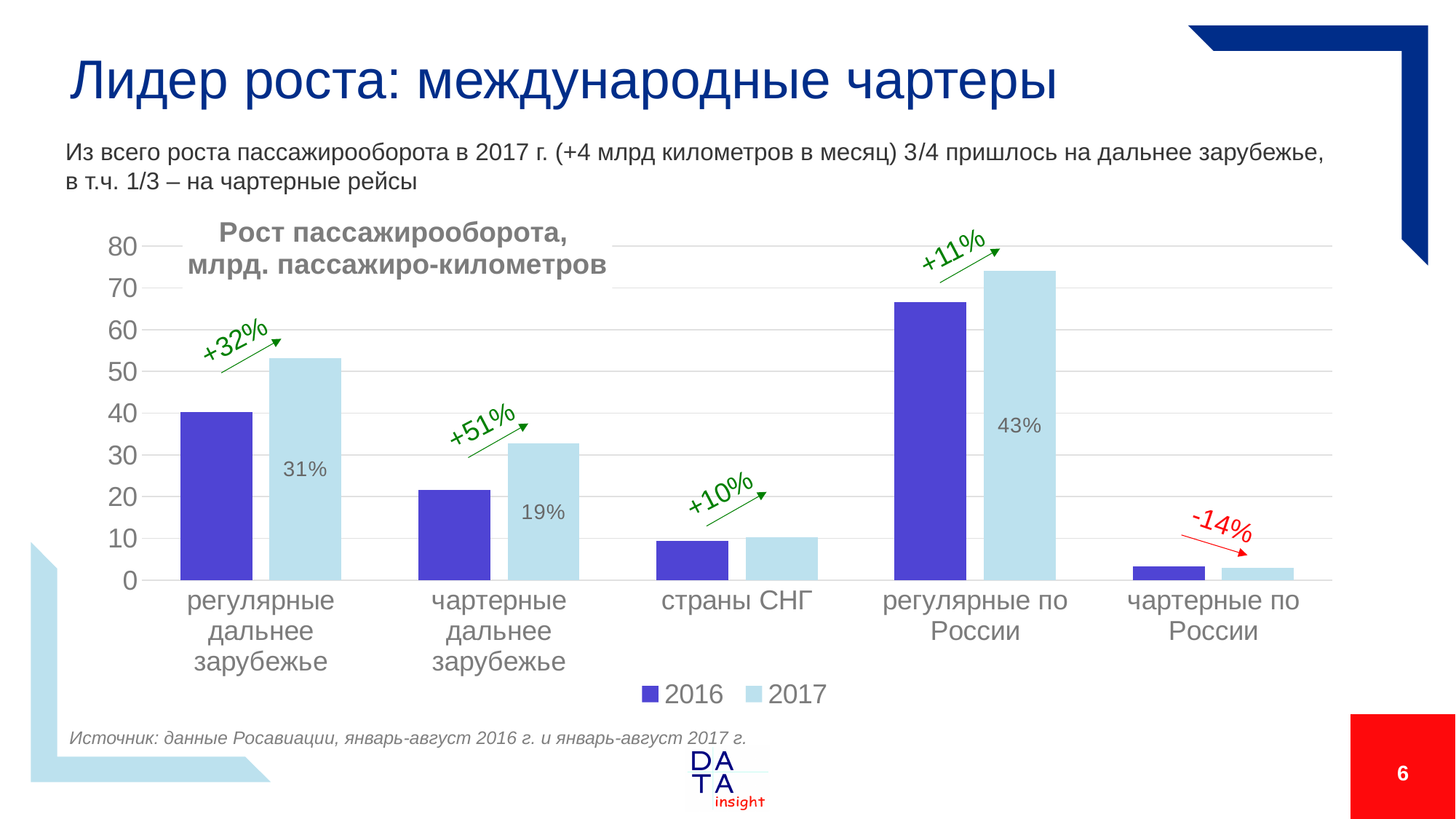
Which category has the highest 2017 value? регулярные по России What growth percentage is annotated above the bars for 'регулярные дальнее зарубежье'? +32% What kind of chart is shown on the slide? bar chart What percentage label is printed inside the 2017 bar for 'регулярные по России'? 43% Is the 2017 value for 'регулярные по России' greater or less than 70? greater How many categories are shown on the x axis of the chart? 5 What percentage change is annotated for 'чартерные по России'? -14% Is the 2016 value for 'чартерные по России' greater or less than 10? less How many series does the chart legend list? 2 What growth percentage is annotated above the bars for 'чартерные дальнее зарубежье'? +51% What is the title of the chart? Рост пассажирооборота, млрд. пассажиро-километров Which category has the lowest 2017 value? чартерные по России